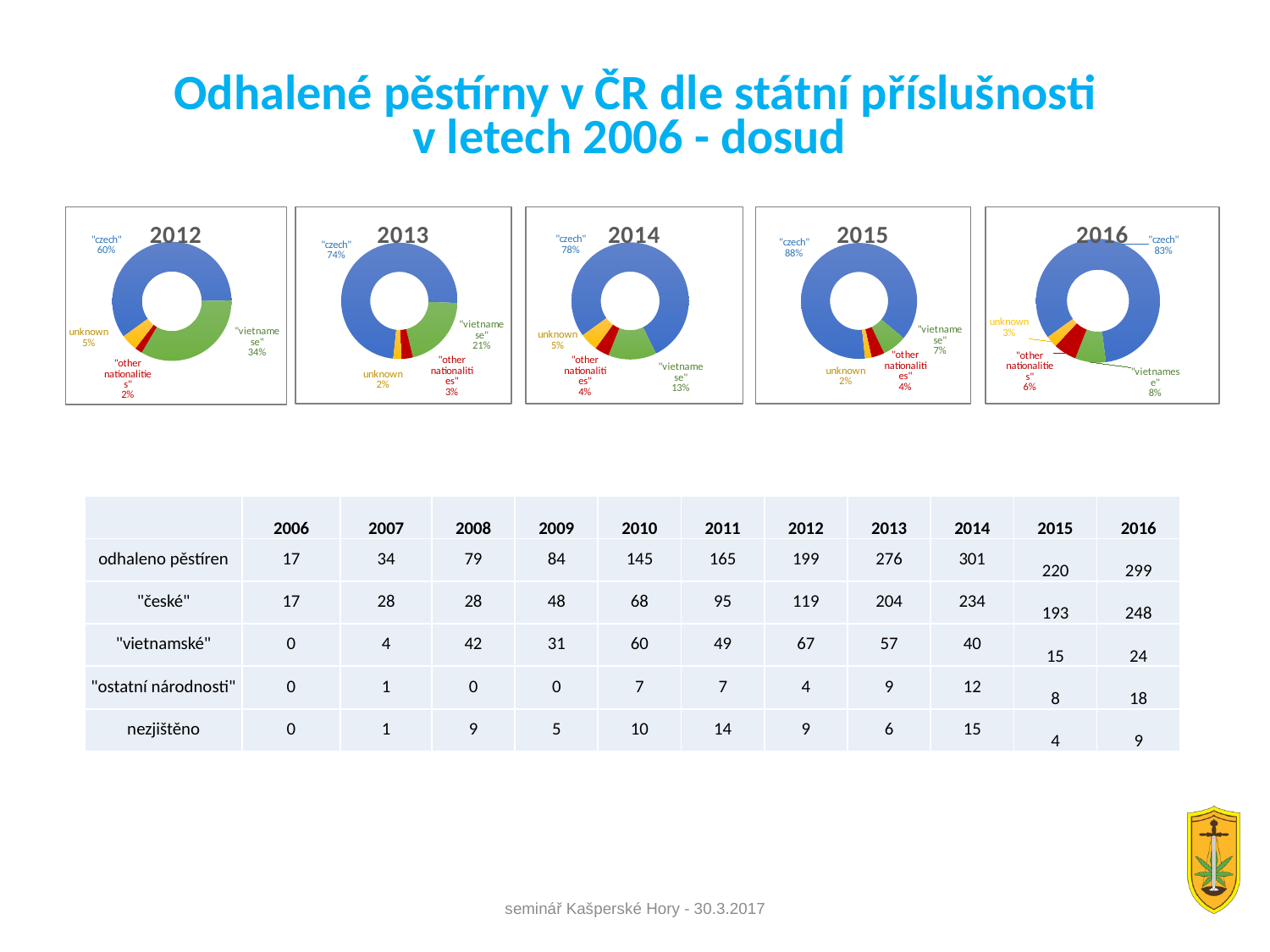
What kind of chart is used for each year on the slide? Donut (pie) chart In the 2013 chart, what share is labelled for "other nationalities"? 3% In the 2013 chart, which category has the smallest share? unknown In the 2014 chart, what share is labelled for unknown? 5% In the 2014 chart, which category has the largest share? "czech" In the 2012 chart, what share is labelled for "czech"? 60% In the 2016 chart, what share is labelled for "vietnamese"? 8% In the 2015 chart, what share is labelled for "czech"? 88% In the 2016 chart, which is larger, the share for "other nationalities" or the share for unknown? "other nationalities" In the 2012 chart, what is the difference between the "czech" share and the "vietnamese" share? 26% In the 2012 chart, what share is labelled for "vietnamese"? 34% How many categories does the 2015 chart show? 4